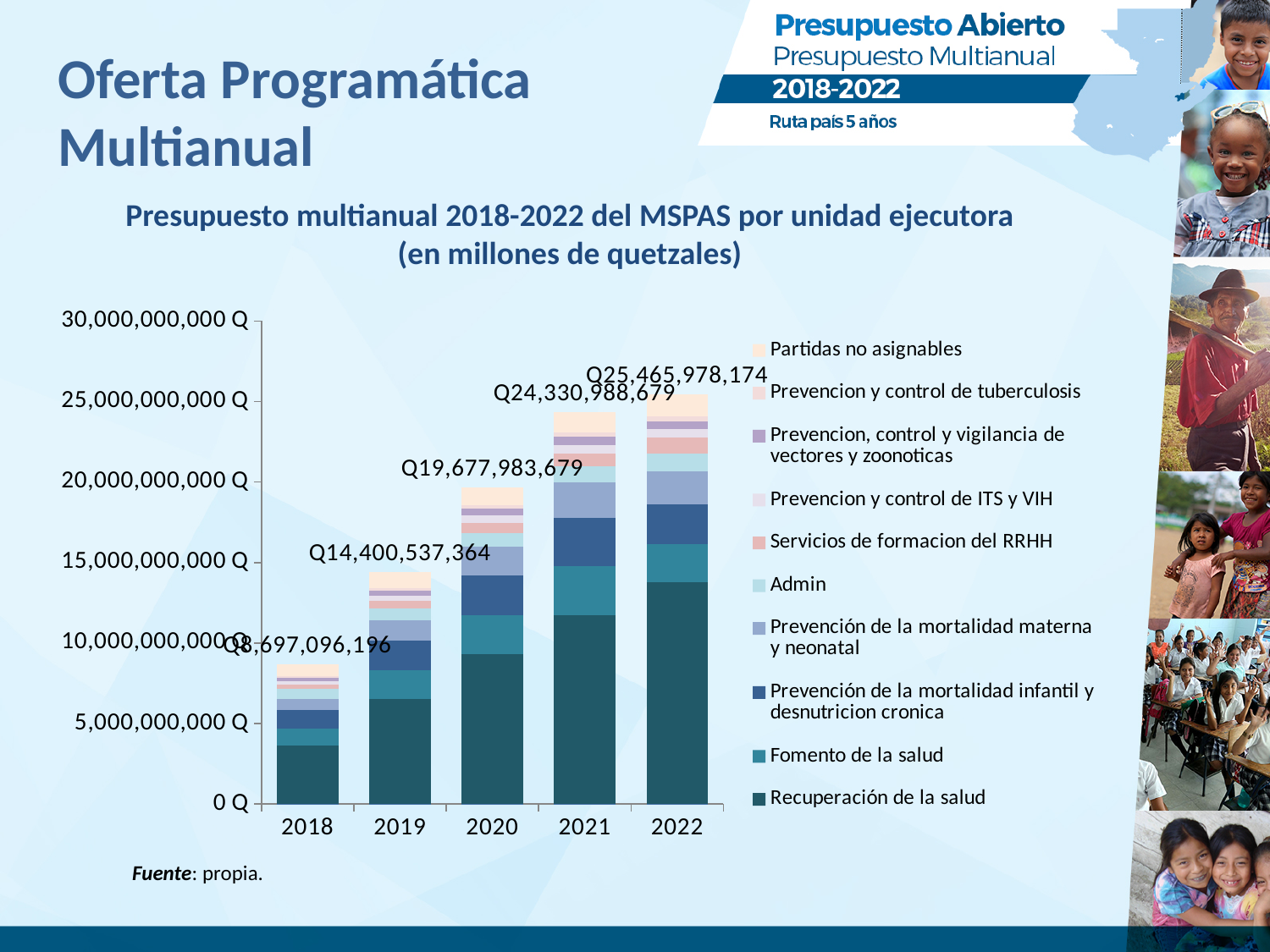
Which year has the highest total budget? 2022 What is the total budget shown for 2018? Q8,697,096,196 Which year has the lowest total budget? 2018 What is the total budget shown for 2020? Q19,677,983,679 Is the value for Recuperación de la salud in 2022 greater or less than 10,000,000,000 Q? greater How many years are shown on the x axis? 5 What is the difference between the total budgets for 2022 and 2021? Q1,134,989,495 Do the total budgets rise or fall from 2018 to 2022? rise Which year has a larger total budget, 2019 or 2020? 2020 What is the total budget shown for 2022? Q25,465,978,174 What is the difference between the total budgets for 2019 and 2018? Q5,703,441,168 How many series does the legend list? 10